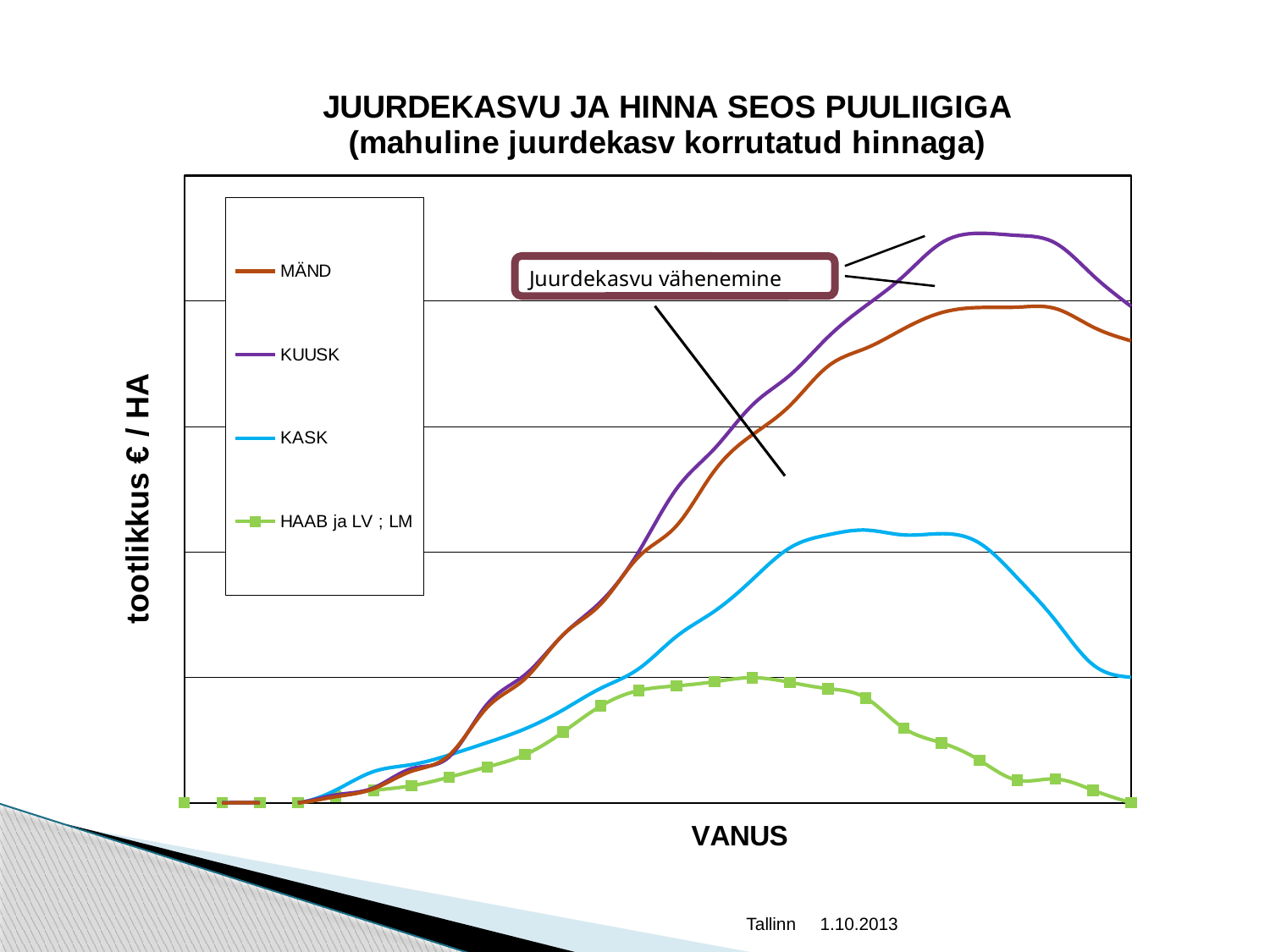
At the right end of the x axis, which series is higher, MÄND or KASK? MÄND Which series reaches the highest value on the chart? KUUSK Which series stays lowest across the chart? HAAB ja LV ; LM What is the label of the y axis? tootlikkus € / HA What kind of chart is shown on the slide? line chart Which series is drawn with square markers? HAAB ja LV ; LM Which series peaks higher, KASK or HAAB ja LV ; LM? KASK What text is in the boxed annotation on the chart? Juurdekasvu vähenemine Which series peaks higher, MÄND or KUUSK? KUUSK How do the values of the KUUSK series change along the x axis? rise, then fall How many series does the legend list? 4